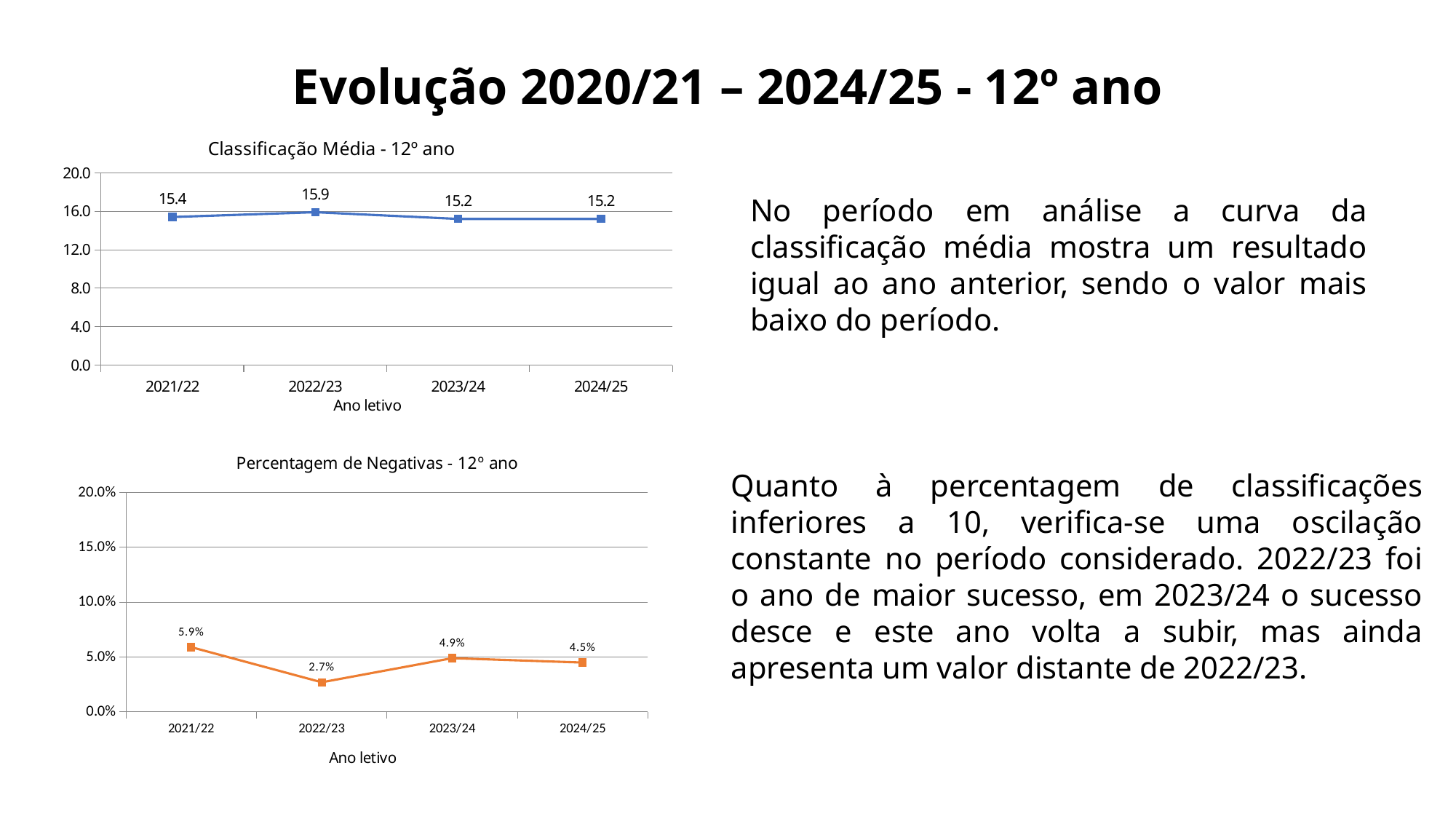
In the 'Classificação Média - 12º ano' chart, how many school years are plotted? 4 In the 'Percentagem de Negativas - 12º ano' chart, is the value for 2021/22 greater or less than 10.0%? less In the 'Percentagem de Negativas - 12º ano' chart, what is the difference between the values for 2021/22 and 2022/23? 3.2% In the 'Classificação Média - 12º ano' chart, what is the difference between the values for 2022/23 and 2021/22? 0.5 In the 'Classificação Média - 12º ano' chart, is the value for 2023/24 greater or less than 12.0? greater What is the x-axis label of the 'Percentagem de Negativas - 12º ano' chart? Ano letivo In the 'Classificação Média - 12º ano' chart, what is the value for 2022/23? 15.9 In the 'Percentagem de Negativas - 12º ano' chart, which school year has the lowest value? 2022/23 What kind of chart is 'Classificação Média - 12º ano'? line chart In the 'Percentagem de Negativas - 12º ano' chart, which is larger, the value for 2023/24 or the value for 2024/25? 2023/24 In the 'Classificação Média - 12º ano' chart, which school year has the highest value? 2022/23 In the 'Percentagem de Negativas - 12º ano' chart, what is the value for 2021/22? 5.9%